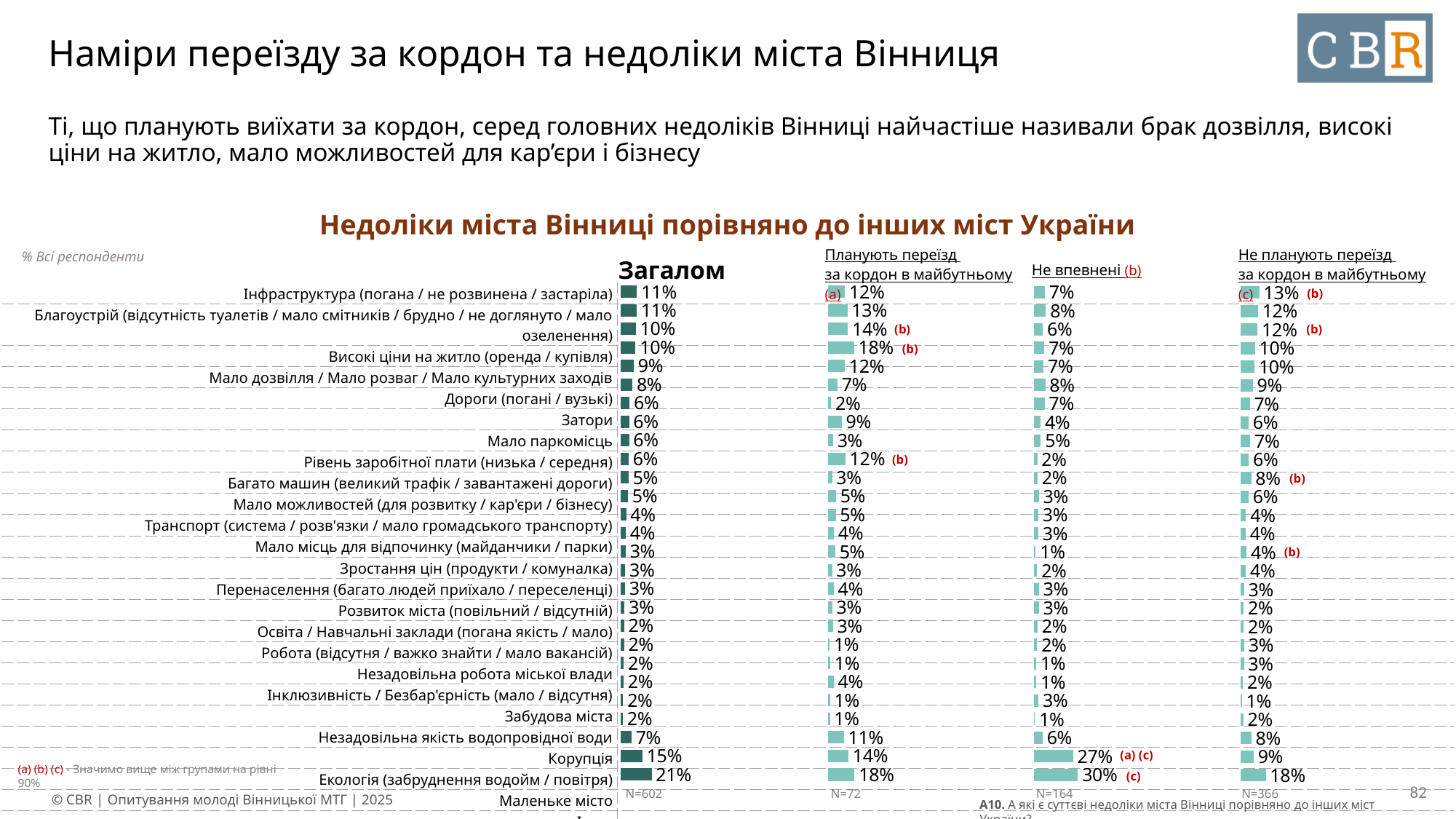
What kind of chart is used on this slide? Bar chart What is the title of the chart? Недоліки міста Вінниці порівняно до інших міст України What is the value for Інфраструктура (погана / не розвинена / застаріла) in the Не планують переїзд за кордон в майбутньому column? 13% What is the sample size (N) shown for the Планують переїзд за кордон в майбутньому group? N=72 How many respondent groups (columns of bars) does the chart show? 4